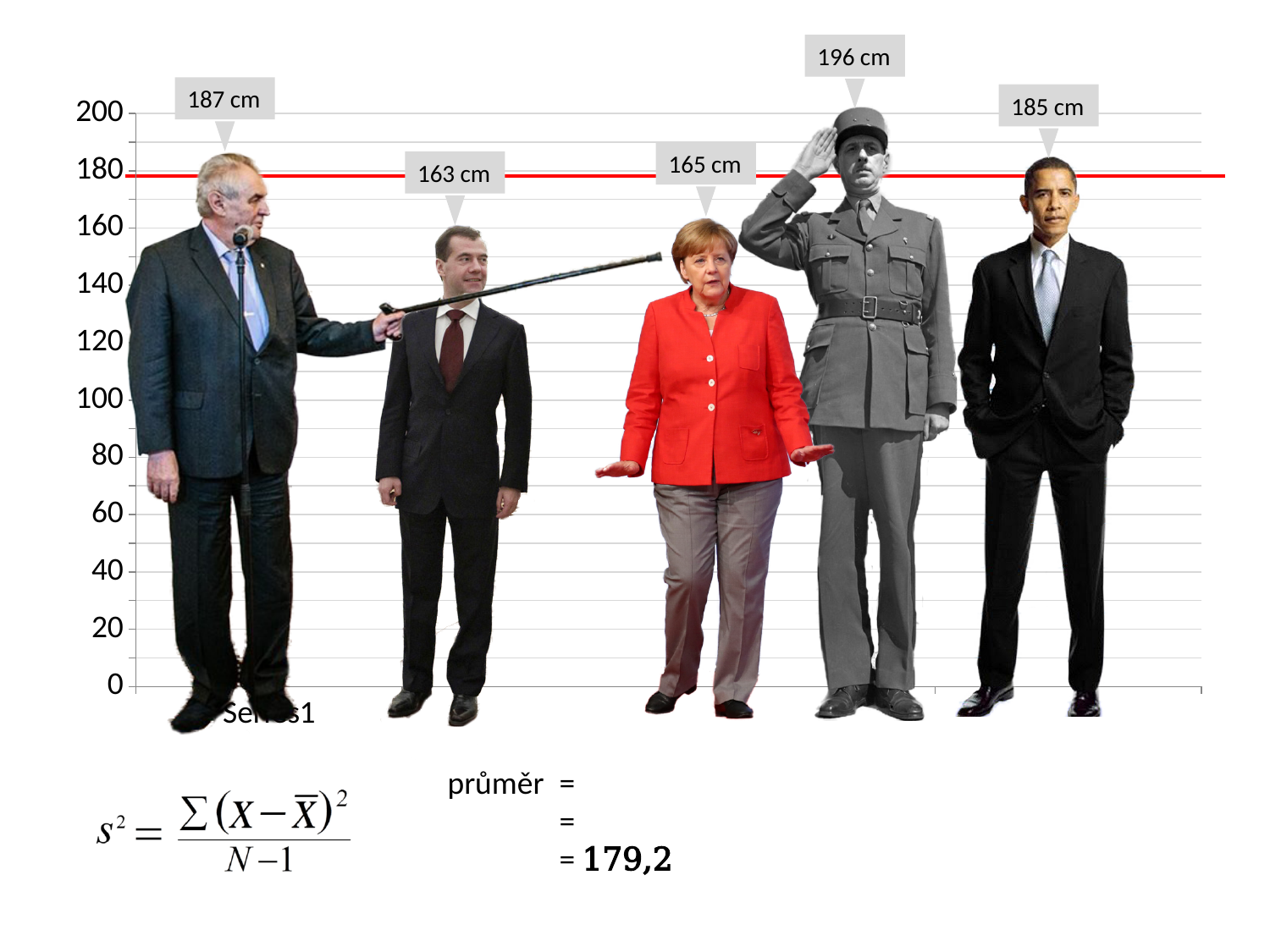
What is the difference between the highest value (196 cm) and the lowest value (163 cm) in the chart? 33 cm What is the value shown for the fourth figure from the left (the one in uniform)? 196 cm How many figures (categories) are plotted in the chart? 5 Which figure has the lowest value in the chart? The second from the left (163 cm) What is the value shown for the third figure from the left (the one in red)? 165 cm What is the highest tick value shown on the vertical axis of the chart? 200 Which is larger: the value for the leftmost figure or the value for the rightmost figure? The leftmost figure (187 cm) What average value (průměr) is stated below the chart? 179,2 Which figure has the highest value in the chart? The fourth from the left (196 cm) What is the value shown for the second figure from the left in the chart? 163 cm What is the value shown for the rightmost figure in the chart? 185 cm What is the value shown for the first (leftmost) figure in the chart? 187 cm